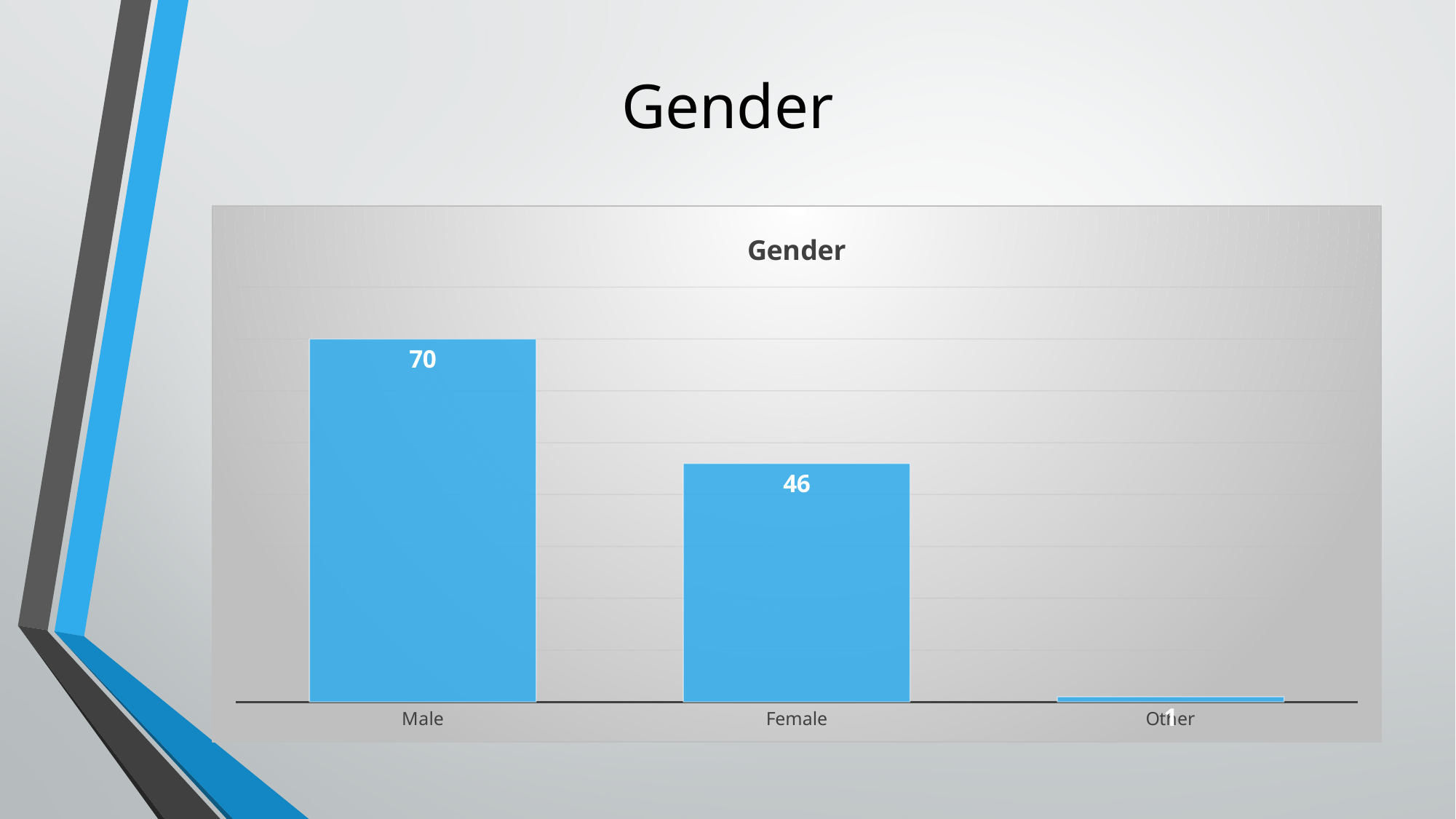
What is the title of the chart on the slide? Gender Which is larger in the Gender chart, the value for Female or the value for Other? Female Do the values rise or fall from left to right across the categories in the Gender chart? Fall How many categories are shown in the Gender chart? 3 Which category has the highest value in the Gender chart? Male What is the value for Female in the Gender chart? 46 What is the difference between the values for Male and Female in the Gender chart? 24 What is the value for Male in the Gender chart? 70 Which category has the lowest value in the Gender chart? Other What kind of chart is shown on the slide? Bar chart Which is larger in the Gender chart, the value for Male or the value for Female? Male What colour are the bars in the Gender chart? Blue